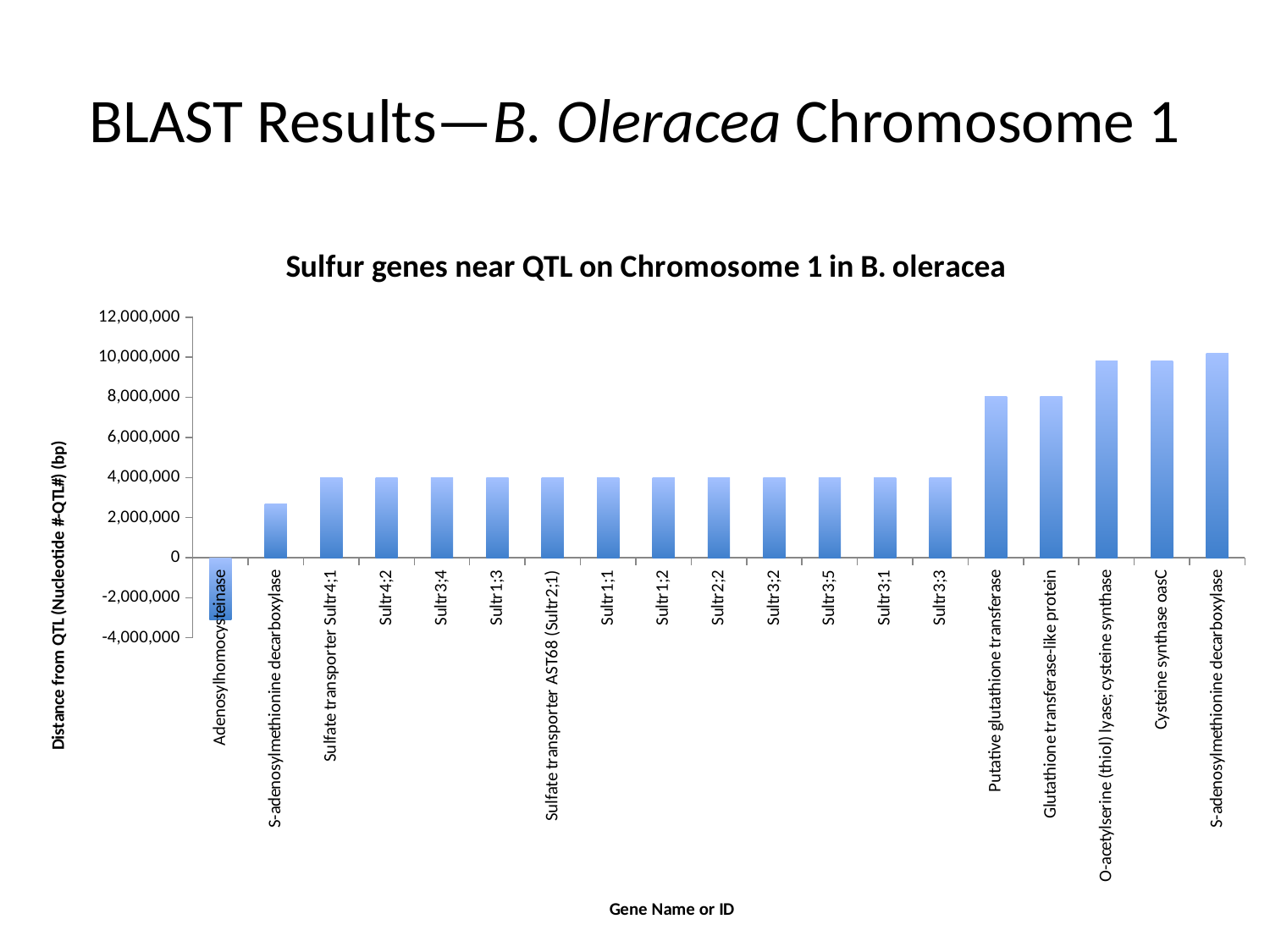
Is the value for Putative glutathione transferase greater or less than 6,000,000? greater How many genes (bars) are plotted in the chart? 19 Which bar is the highest in the chart? S-adenosylmethionine decarboxylase (the rightmost bar) What is the label of the vertical axis of the chart? Distance from QTL (Nucleotide #-QTL#) (bp) What kind of chart is shown on the slide? Bar chart Is the value for Sultr4;2 greater or less than 6,000,000? less Which has the larger value, Putative glutathione transferase or Sultr1;1? Putative glutathione transferase Is the value for Adenosylhomocysteinase greater or less than 0? less Which has the larger value, Cysteine synthase oasC or Sultr3;3? Cysteine synthase oasC Which gene has the lowest distance from QTL value in the chart? Adenosylhomocysteinase What is the title of the chart? Sulfur genes near QTL on Chromosome 1 in B. oleracea